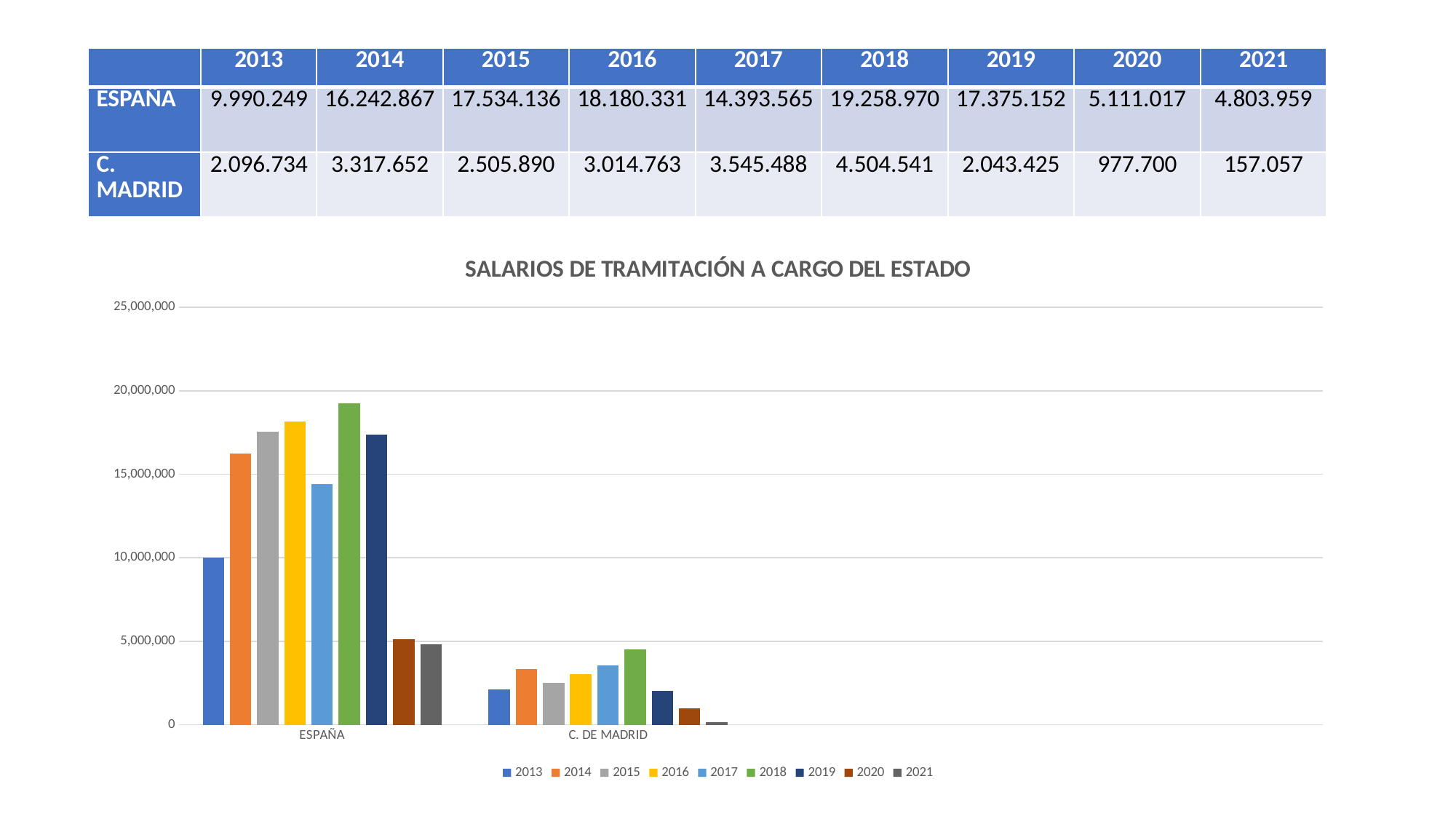
How many categories are shown on the x axis of the chart? 2 How many series does the chart legend list? 9 Do the values for ESPAÑA rise or fall from 2019 to 2021? fall What is the difference between the ESPAÑA values for 2020 and 2021? 307.058 What is the value for C. MADRID in 2021? 157.057 Is the value for ESPAÑA in 2013 greater or less than 15,000,000? less What type of chart is shown on the slide? bar chart What is the title of the chart? SALARIOS DE TRAMITACIÓN A CARGO DEL ESTADO Which year has the highest value for ESPAÑA? 2018 What is the value for ESPAÑA in 2018? 19.258.970 Which is larger for C. MADRID: the 2014 value or the 2016 value? 2014 Which year has the lowest value for C. MADRID? 2021